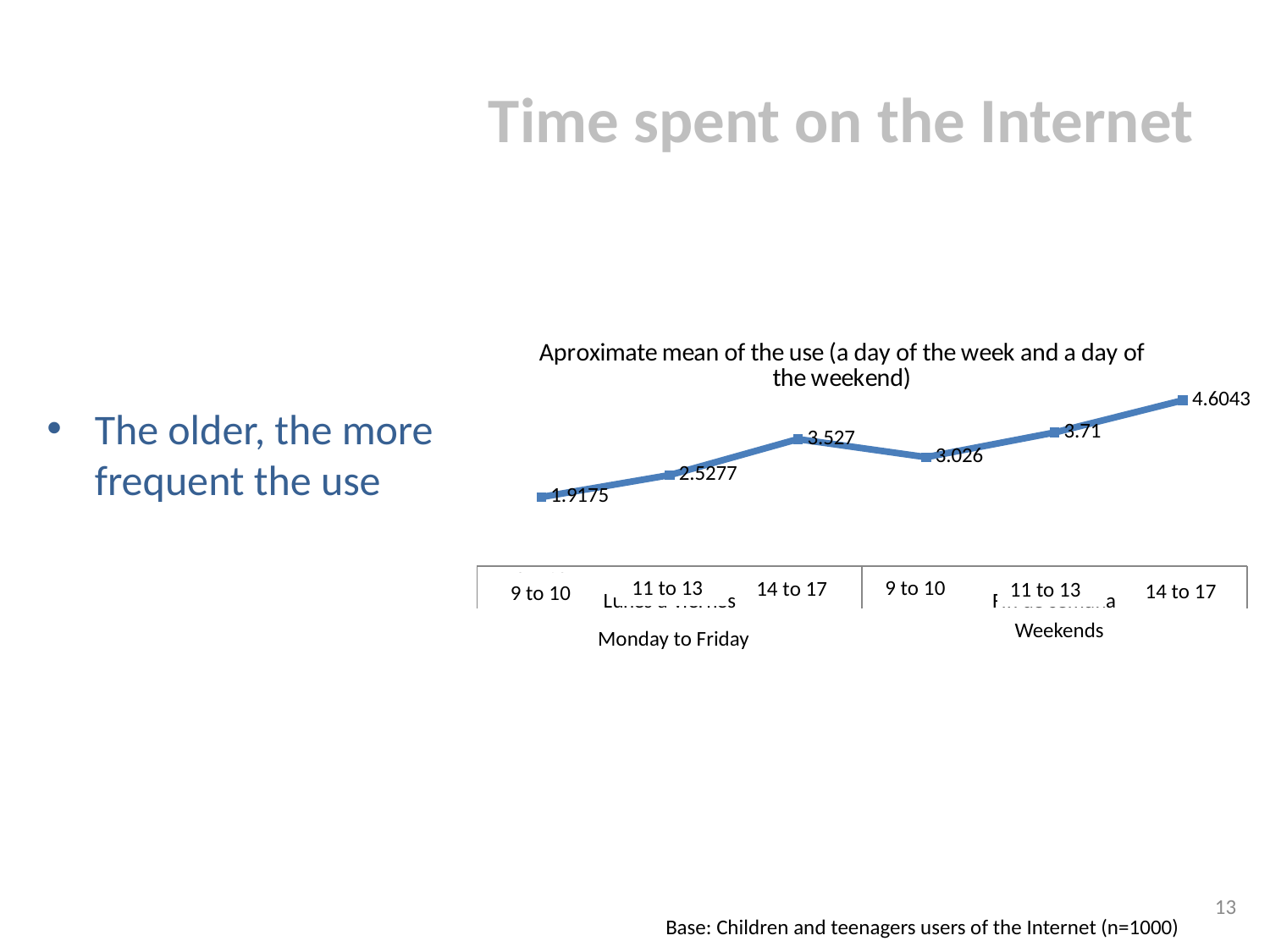
What is the approximate mean use for the 11 to 13 age group from Monday to Friday? 2.5277 What is the approximate mean use for the 9 to 10 age group on weekends? 3.026 What is the title of the chart? Aproximate mean of the use (a day of the week and a day of the weekend) What kind of chart is shown on the slide? Line chart What is the approximate mean use for the 14 to 17 age group on weekends? 4.6043 Which age group and period has the highest approximate mean use? 14 to 17, Weekends Which is larger: the Monday to Friday value for 14 to 17 or the weekend value for 9 to 10? Monday to Friday value for 14 to 17 Which age group and period has the lowest approximate mean use? 9 to 10, Monday to Friday Within the Monday to Friday group, do the values rise or fall as the age group increases? Rise How many data points are plotted on the chart? 6 What is the difference between the weekend value for 14 to 17 and the Monday to Friday value for 14 to 17? 1.0773 What is the approximate mean use for the 9 to 10 age group from Monday to Friday? 1.9175